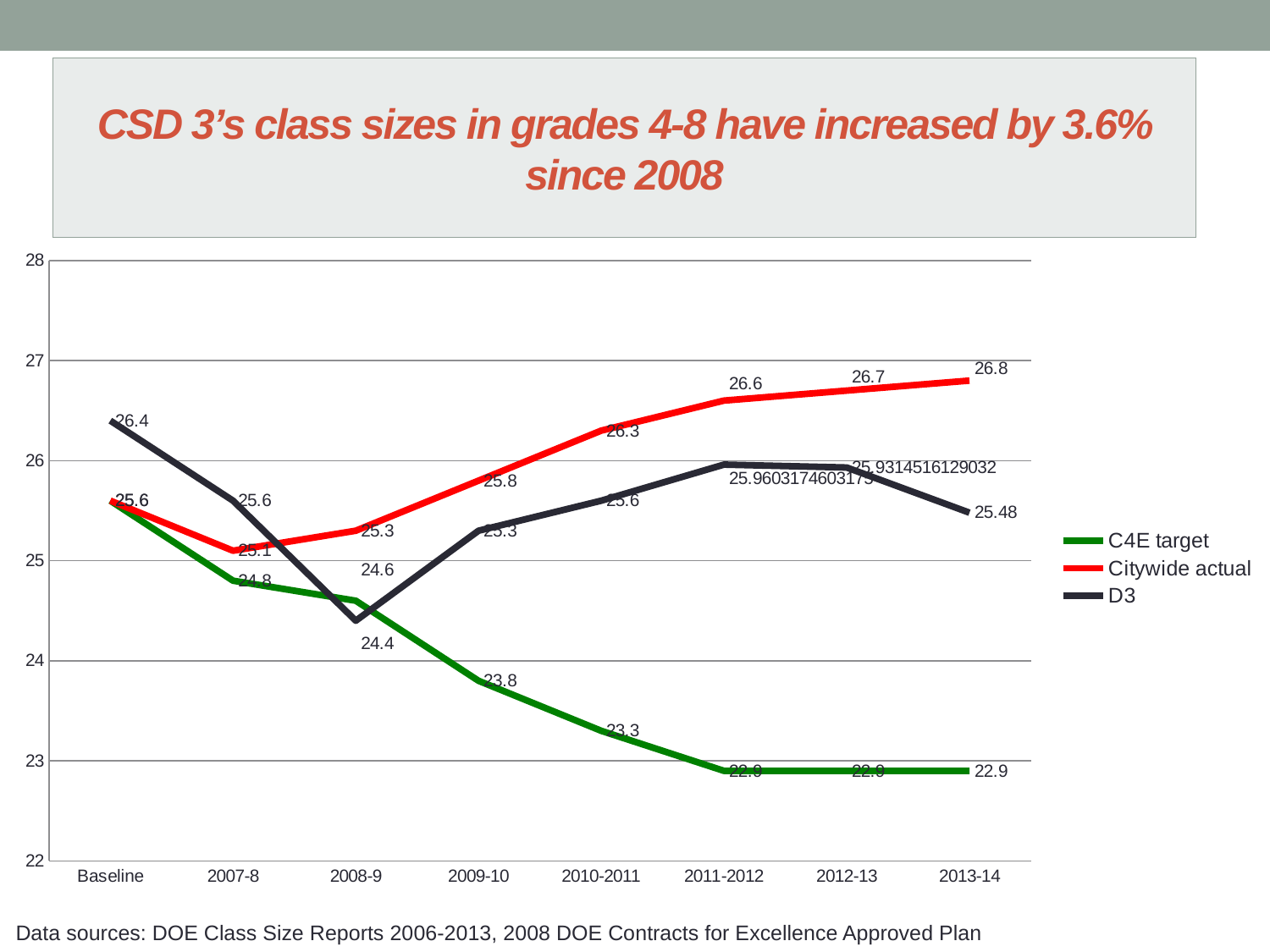
How many series does the legend list? 3 In which year is the D3 value lowest? 2008-9 What is the D3 value for 2013-14? 25.48 What is the Citywide actual value for 2013-14? 26.8 What kind of chart is shown on the slide? line chart How many points are plotted along the x axis for each series? 8 In which year is the Citywide actual value highest? 2013-14 What is the difference between the Citywide actual and C4E target values in 2013-14? 3.9 What is the C4E target value for 2013-14? 22.9 In 2013-14, which is larger: Citywide actual or D3? Citywide actual What is the D3 value at Baseline? 26.4 Does the C4E target series rise or fall from Baseline to 2013-14? fall